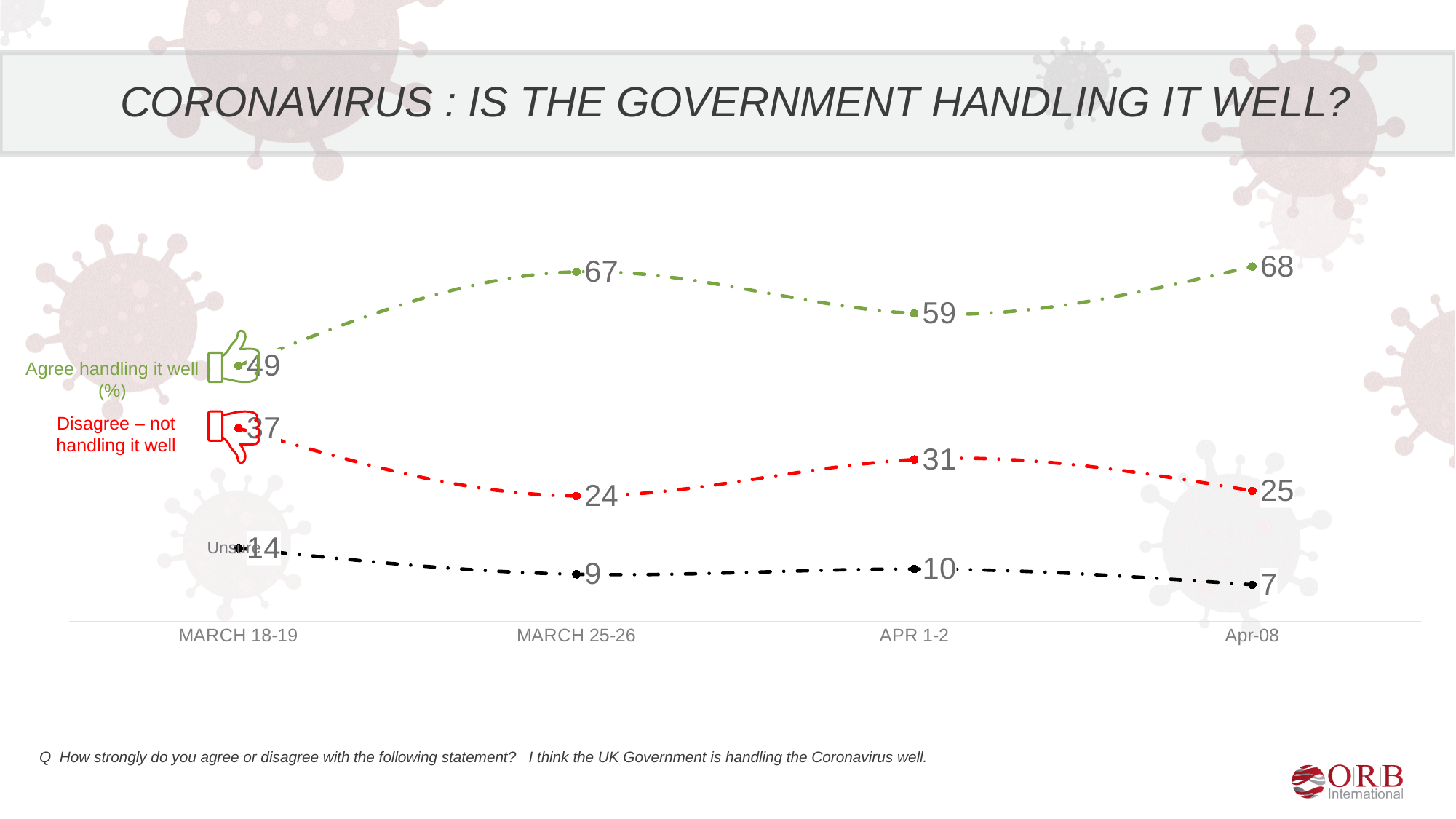
What is the difference between the 'Agree handling it well' value at Apr-08 and at March 18-19? 19 What is the value for 'Disagree – not handling it well' at Apr 1-2? 31 Does the 'Unsure' series generally rise or fall from March 18-19 to Apr-08? fall How many series are plotted on the chart? 3 What is the title of the slide? CORONAVIRUS : IS THE GOVERNMENT HANDLING IT WELL? What is the value for 'Agree handling it well' at March 25-26? 67 What is the value for 'Unsure' at Apr-08? 7 What type of chart is shown on the slide? line chart Which is larger: the 'Disagree – not handling it well' value at March 18-19 or at Apr-08? MARCH 18-19 At which date is the 'Agree handling it well' value highest? Apr-08 How many dates are plotted on the x axis? 4 At which date is the 'Disagree – not handling it well' value lowest? MARCH 25-26